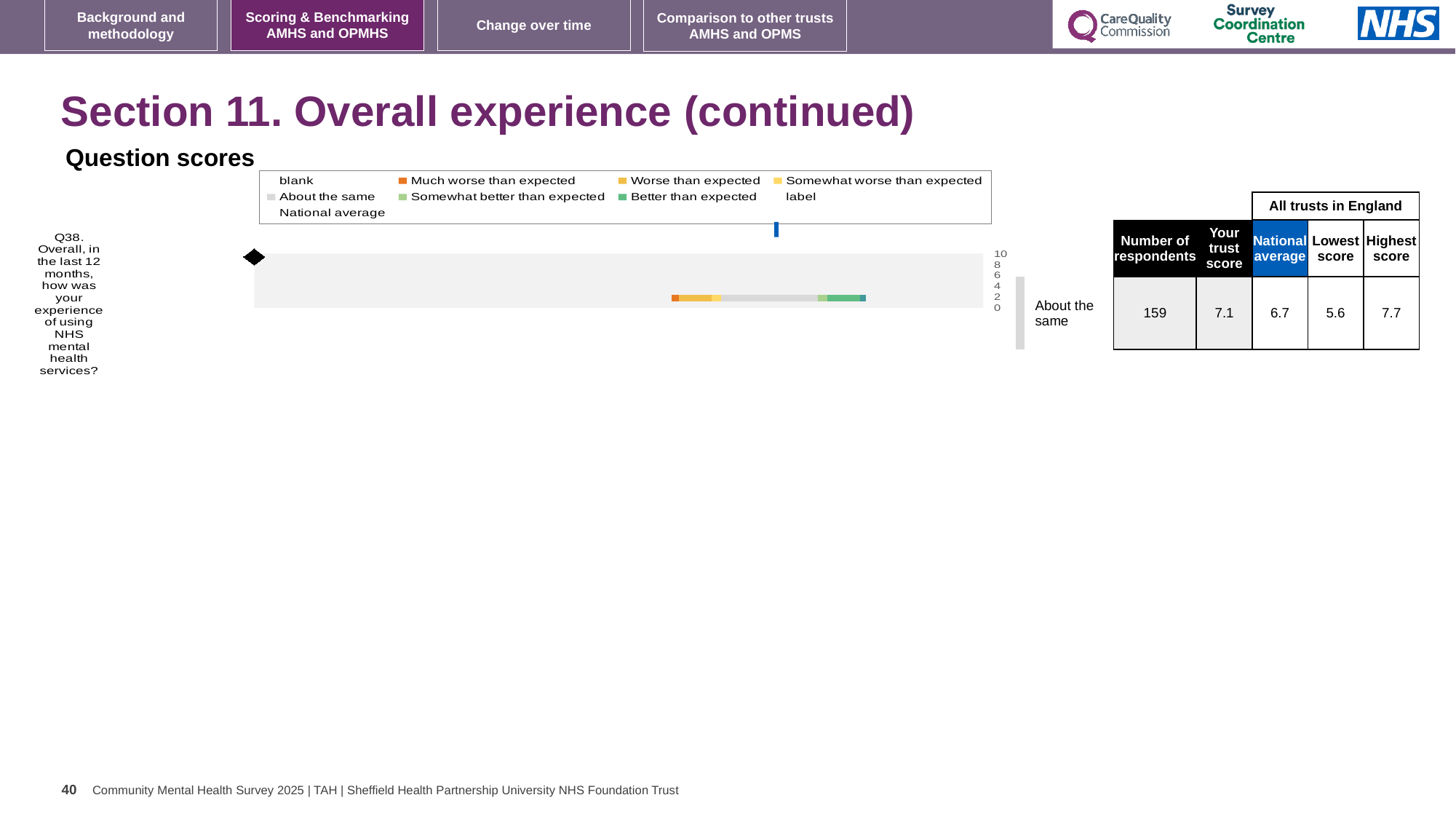
In the table next to the chart, what is 'Your trust score' for Q38? 7.1 In the table next to the chart, what is the National average for Q38? 6.7 How many questions (categories) are plotted in the Question scores chart? 1 What is the highest tick value shown on the axis of the Question scores chart? 10 Is the trust score for Q38 larger or smaller than the National average? larger Which question is plotted in the Question scores chart? Q38. Overall, in the last 12 months, how was your experience of using NHS mental health services? What benchmark category label is shown beside the Q38 bar? About the same In the table next to the chart, what is the Lowest score among all trusts in England for Q38? 5.6 In the table next to the chart, what is the number of respondents for Q38? 159 What kind of chart is shown under 'Question scores'? bar chart What is the difference between the Highest score and the Lowest score for Q38 in the table? 2.1 In the table next to the chart, what is the Highest score among all trusts in England for Q38? 7.7